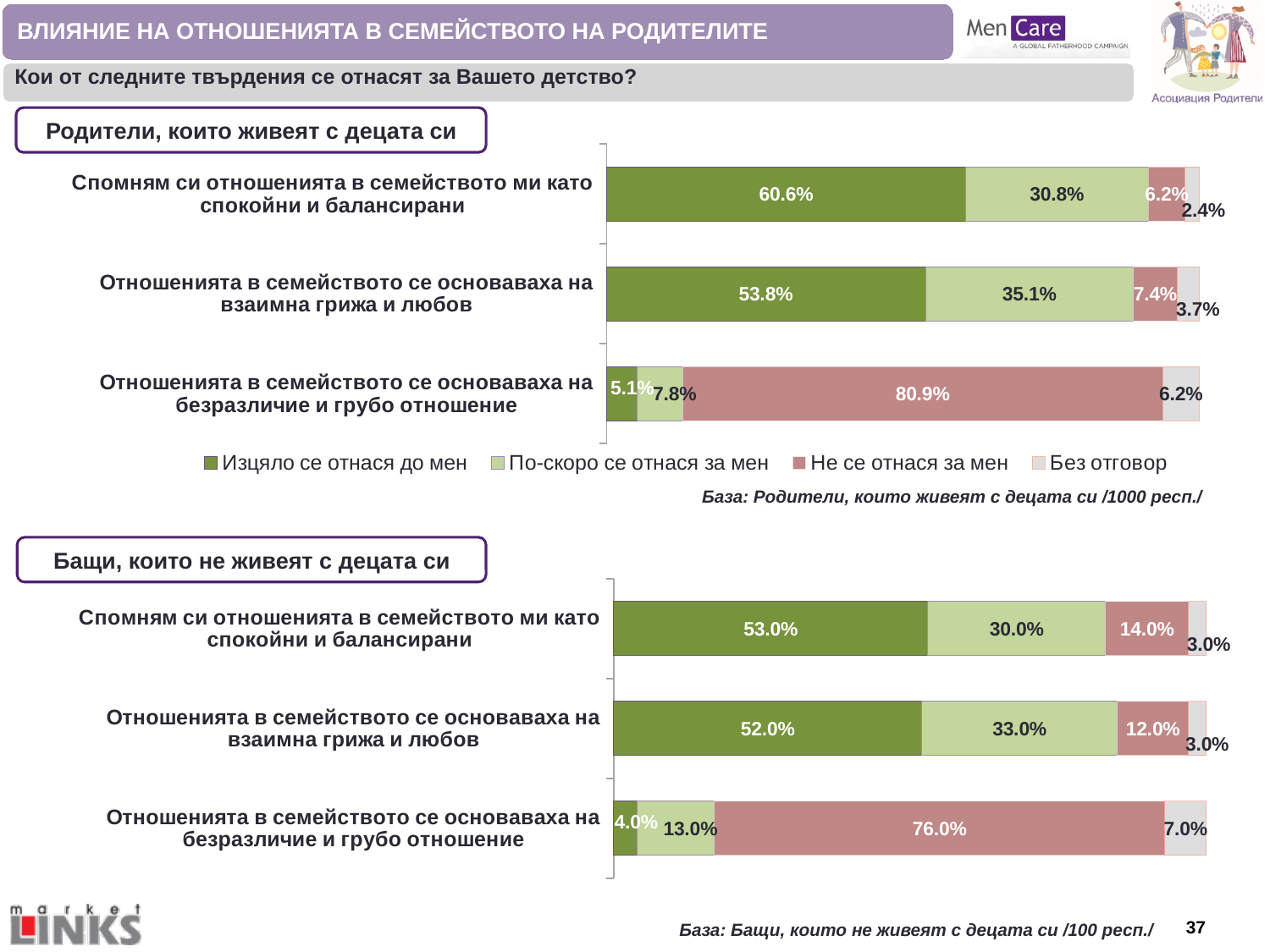
In the chart 'Родители, които живеят с децата си', which statement has the highest value for 'Изцяло се отнася до мен'? Спомням си отношенията в семейството ми като спокойни и балансирани In the chart 'Бащи, които не живеят с децата си', which statement has the lowest value for 'Не се отнася за мен'? Отношенията в семейството се основаваха на взаимна грижа и любов In the chart 'Родители, които живеят с децата си', what is the value of 'Изцяло се отнася до мен' for 'Спомням си отношенията в семейството ми като спокойни и балансирани'? 60.6% What type of chart is 'Родители, които живеят с децата си'? Stacked bar chart How many statements (categories) are shown in the chart 'Бащи, които не живеят с децата си'? 3 In the chart 'Родители, които живеят с децата си', what is the value of 'Не се отнася за мен' for 'Отношенията в семейството се основаваха на безразличие и грубо отношение'? 80.9% In the chart 'Бащи, които не живеят с децата си', what is the value of 'По-скоро се отнася за мен' for 'Отношенията в семейството се основаваха на взаимна грижа и любов'? 33.0% In the chart 'Бащи, които не живеят с децата си', what is the value of 'Без отговор' for 'Отношенията в семейството се основаваха на безразличие и грубо отношение'? 7.0% In the chart 'Бащи, които не живеят с децата си', what is the total of the stacked bar for 'Спомням си отношенията в семейството ми като спокойни и балансирани'? 100.0% Which is larger: the 'Не се отнася за мен' value for 'Отношенията в семейството се основаваха на безразличие и грубо отношение' in the chart 'Родители, които живеят с децата си' or in the chart 'Бащи, които не живеят с децата си'? Родители, които живеят с децата си How many series does the legend list on the slide? 4 In the chart 'Родители, които живеят с децата си', what is the difference between the 'Изцяло се отнася до мен' values for 'Спомням си отношенията в семейството ми като спокойни и балансирани' and 'Отношенията в семейството се основаваха на взаимна грижа и любов'? 6.8%